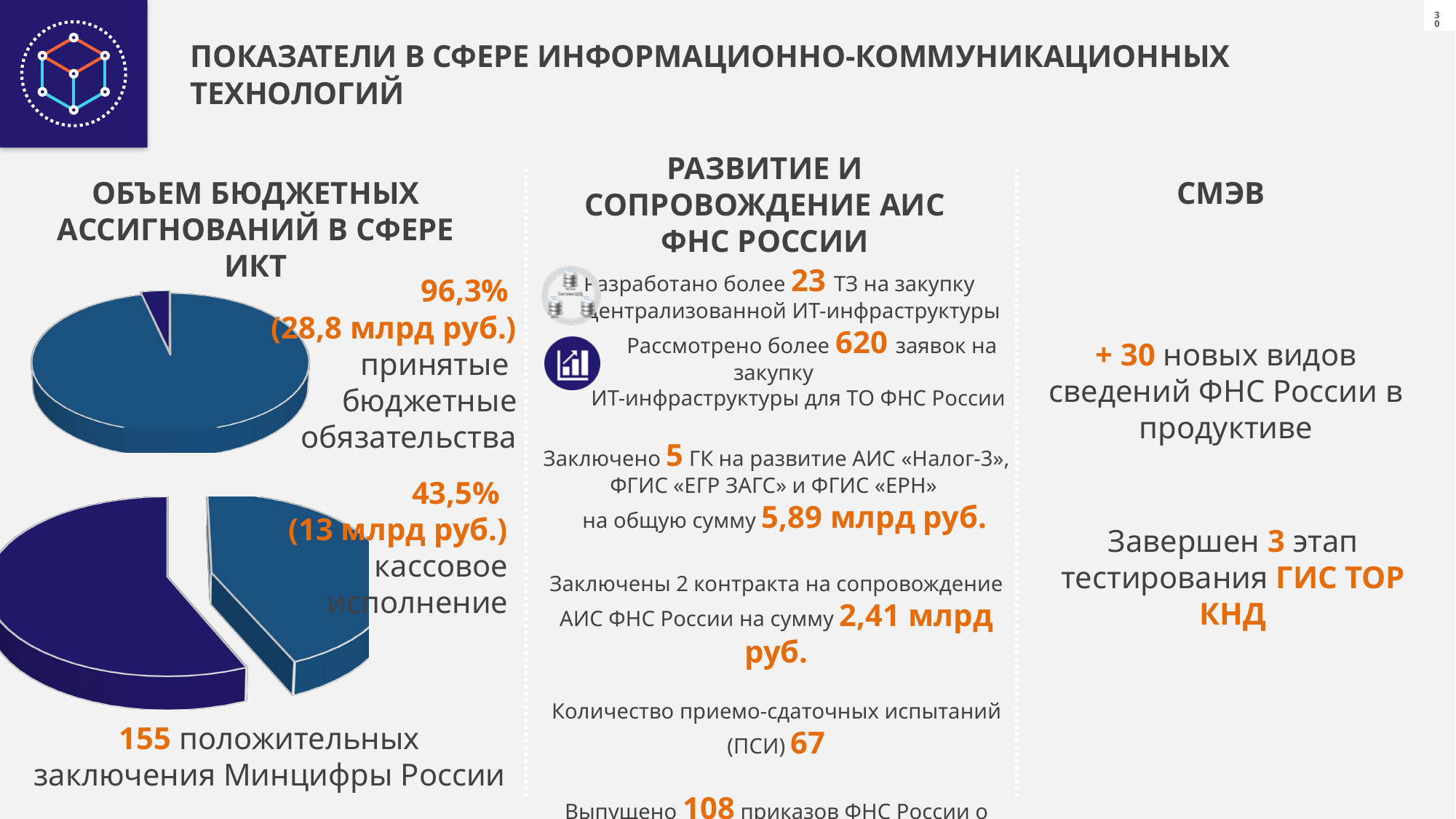
What is the title of the section containing the two pie charts? ОБЪЕМ БЮДЖЕТНЫХ АССИГНОВАНИЙ В СФЕРЕ ИКТ What kind of chart is the top chart on the left side of the slide? Pie chart In the bottom pie chart, what amount in rubles corresponds to the 43,5% slice? 13 млрд руб. In the top pie chart, what amount in rubles corresponds to the 96,3% slice? 28,8 млрд руб. In the bottom pie chart, is the labelled slice (43,5%) the larger or the smaller of the two slices? Smaller How many slices does the top pie chart have? 2 How many slices does the bottom pie chart have? 2 What kind of chart is the bottom chart on the left side of the slide? Pie chart In the bottom pie chart, is the share of the labelled slice greater or less than 50%? less In the top pie chart, what percentage is labelled for the accepted budget obligations (принятые бюджетные обязательства)? 96,3% In the bottom pie chart, what percentage is labelled for cash execution (кассовое исполнение)? 43,5% In the top pie chart, is the labelled slice (96,3%) the larger or the smaller of the two slices? Larger